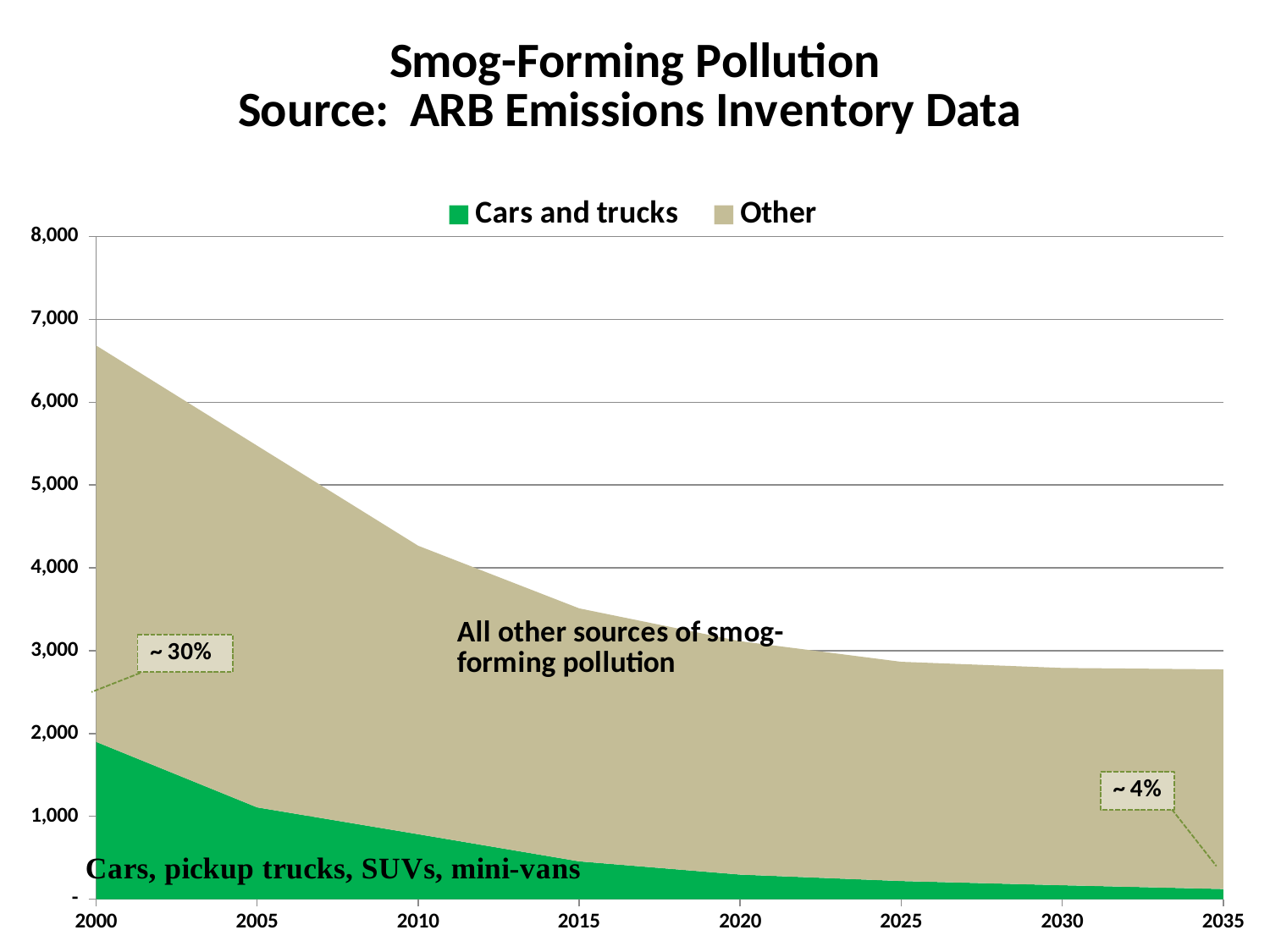
Is the value for Cars and trucks in 2000 greater or less than 1,000? greater How many series does the legend list? 2 Is the total smog-forming pollution in 2000 greater or less than 6,000? greater Which series is larger in 2020, Cars and trucks or Other? Other Is the value for Cars and trucks in 2000 greater or less than 2,000? less Does total smog-forming pollution rise or fall from 2000 to 2035? Fall How many year labels are shown on the x axis? 8 What kind of chart is shown on the slide? Stacked area chart What percentage label is shown in the callout near 2035? ~ 4% What are the two series named in the legend? Cars and trucks; Other